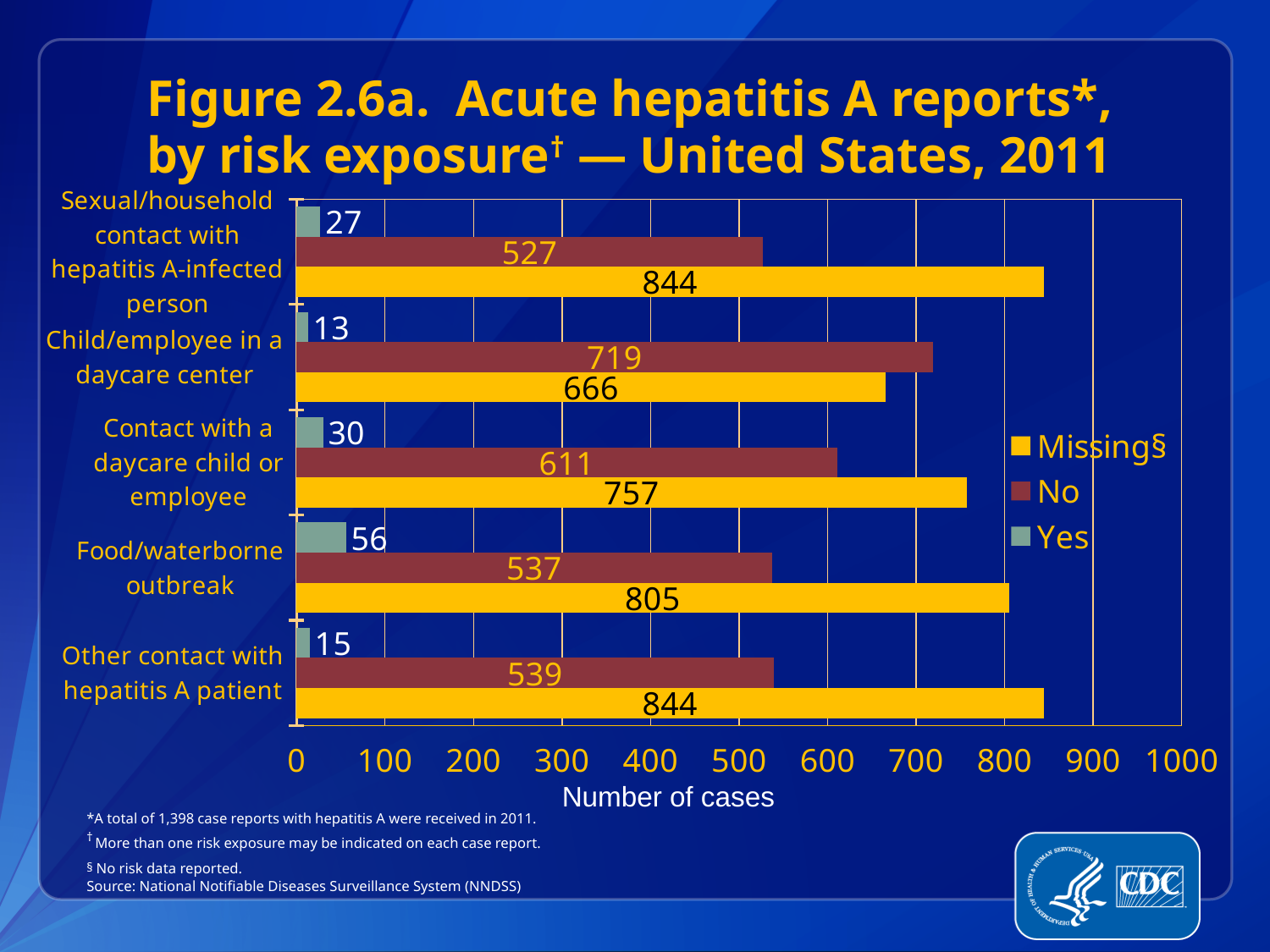
What is the difference between the "No" and "Missing" values for Child/employee in a daycare center? 53 What type of chart is shown on the slide? bar chart Which is larger for Contact with a daycare child or employee: the "No" value or the "Missing" value? Missing What is the "Missing" value for Contact with a daycare child or employee? 757 What is the "No" value for Child/employee in a daycare center? 719 Which risk exposure category has the highest "Yes" value? Food/waterborne outbreak How many cases are reported as "Yes" for Food/waterborne outbreak? 56 How many series does the legend list? 3 Which category has the lowest "Missing" value? Child/employee in a daycare center Which risk exposure category has the lowest "Yes" value? Child/employee in a daycare center How many risk exposure categories are shown on the chart? 5 Is the "No" value for Sexual/household contact with hepatitis A-infected person greater or less than 600? less